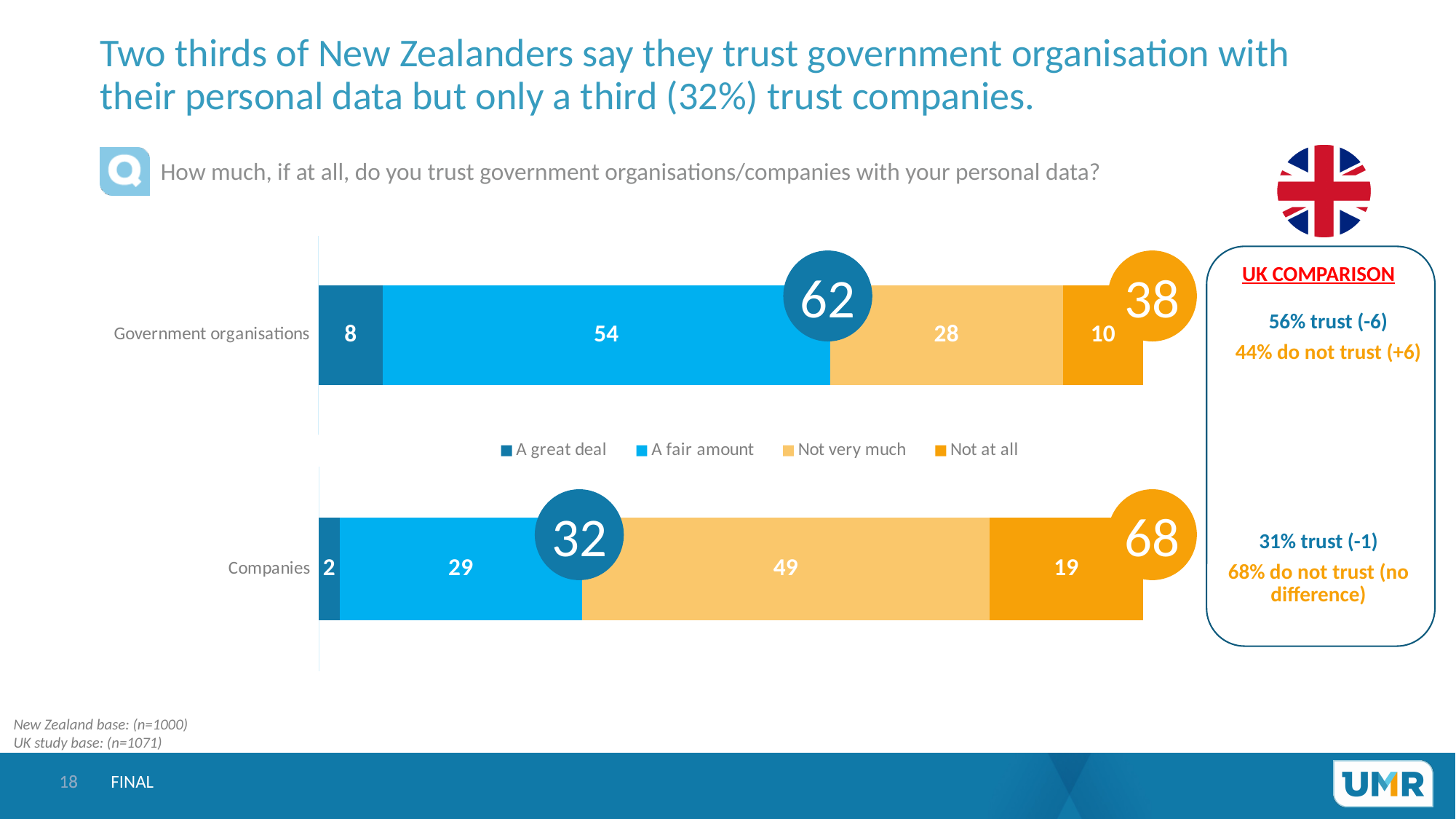
What is the value for 'A great deal' for Companies? 2 What is the value for 'A fair amount' for Government organisations? 54 Which category has the higher value for 'Not at all', Government organisations or Companies? Companies What is the total of the 'A great deal' and 'A fair amount' segments for Government organisations? 62 What kind of chart is shown on the slide? Stacked bar chart How many series does the legend list? 4 What is the value for 'Not very much' for Companies? 49 Which legend entry is shown in dark orange? Not at all What is the total of the 'Not very much' and 'Not at all' segments for Companies? 68 What is the difference between the 'A fair amount' values for Government organisations and Companies? 25 What is the value for 'Not at all' for Government organisations? 10 How many categories are shown on the chart? 2